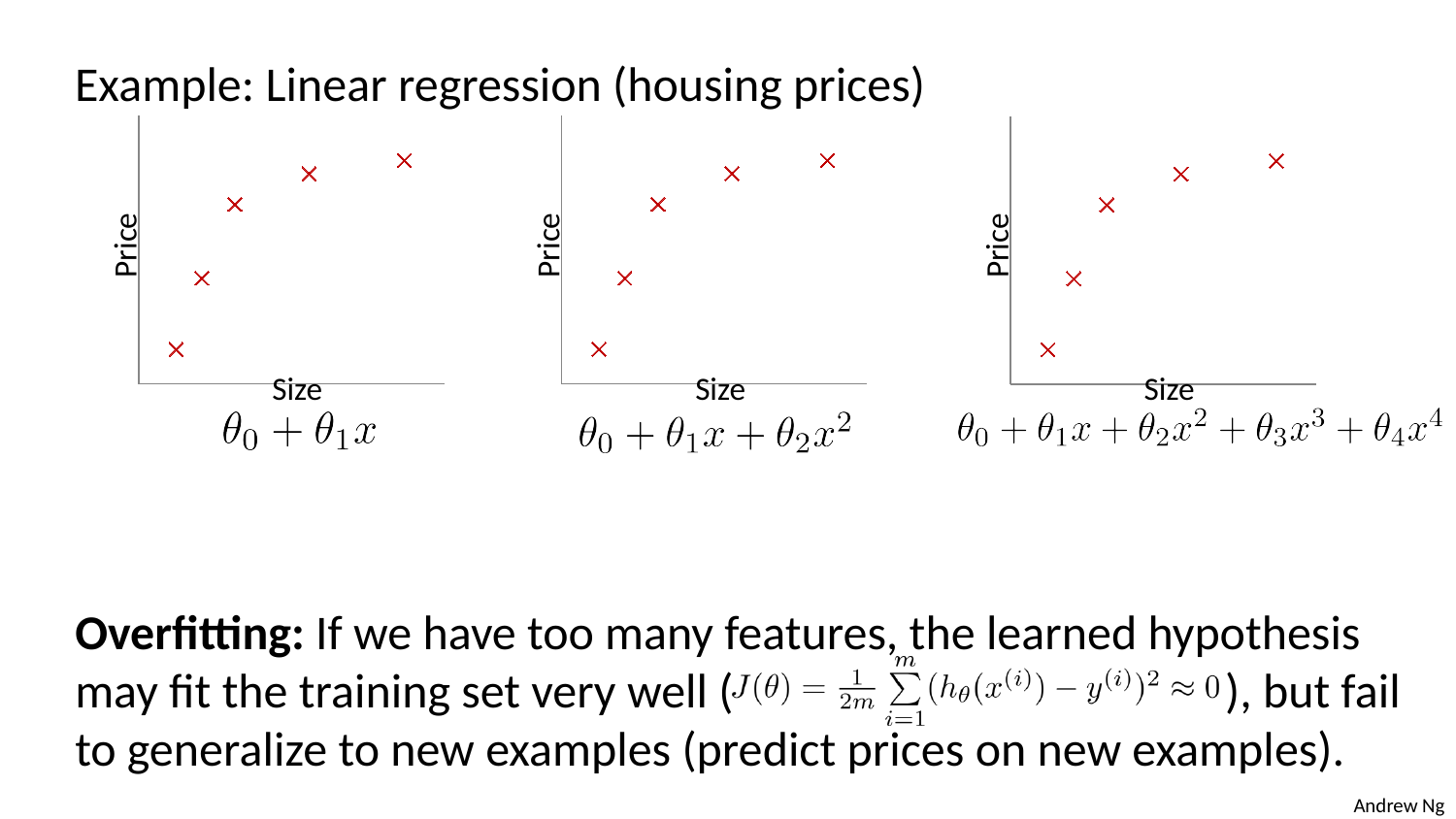
What is the label of the x axis in the middle chart? Size In the middle chart, which point has the highest Price: the one with the largest Size or the one with the smallest Size? the one with the largest Size In the right chart, do the plotted values rise or fall along the x axis? rise In the left chart, do the plotted values rise or fall as Size increases? rise What is the label of the y axis in the left chart? Price How many data points are plotted in the left chart? 5 What kind of chart is the left chart on the slide? scatter plot How many data points are plotted in the right chart? 5 In the left chart, is the point with the smallest Size the lowest or highest in Price? lowest How many data points are plotted in the middle chart? 5